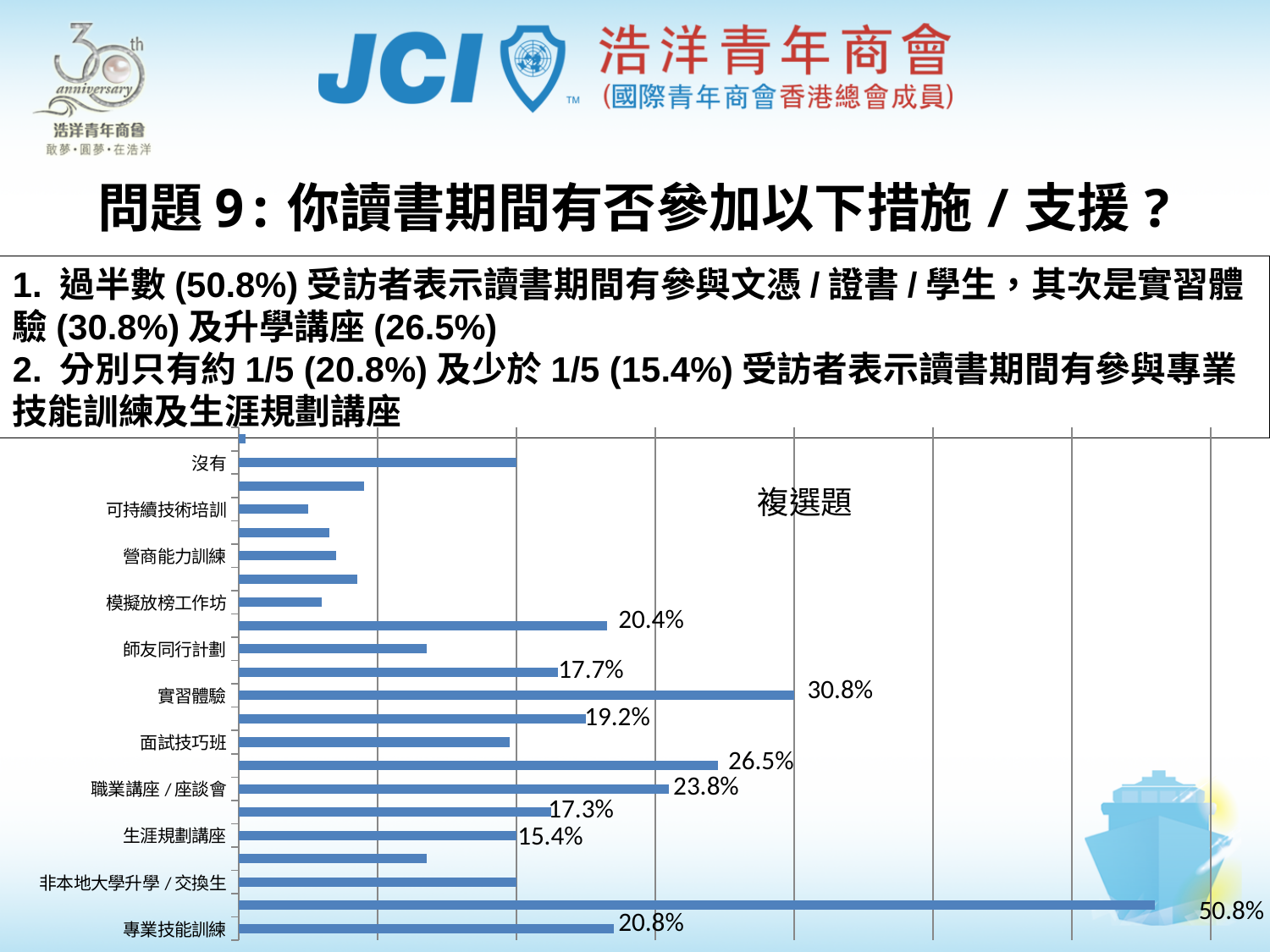
What is the value for 生涯規劃講座? 15.4% Which is larger, the value for 實習體驗 or the value for 職業講座／座談會? 實習體驗 What kind of chart is shown on the slide? bar chart What is the value for 實習體驗? 30.8% What note is printed inside the chart area? 複選題 What is the largest value labelled on the chart? 50.8% What is the difference between the values for 實習體驗 and 生涯規劃講座? 15.4% What is the value for 職業講座／座談會? 23.8% What colour are the bars in the chart? blue Which is larger, the value for 專業技能訓練 or the value for 生涯規劃講座? 專業技能訓練 What is the difference between the values for 實習體驗 and 職業講座／座談會? 7.0% What is the value for 專業技能訓練? 20.8%